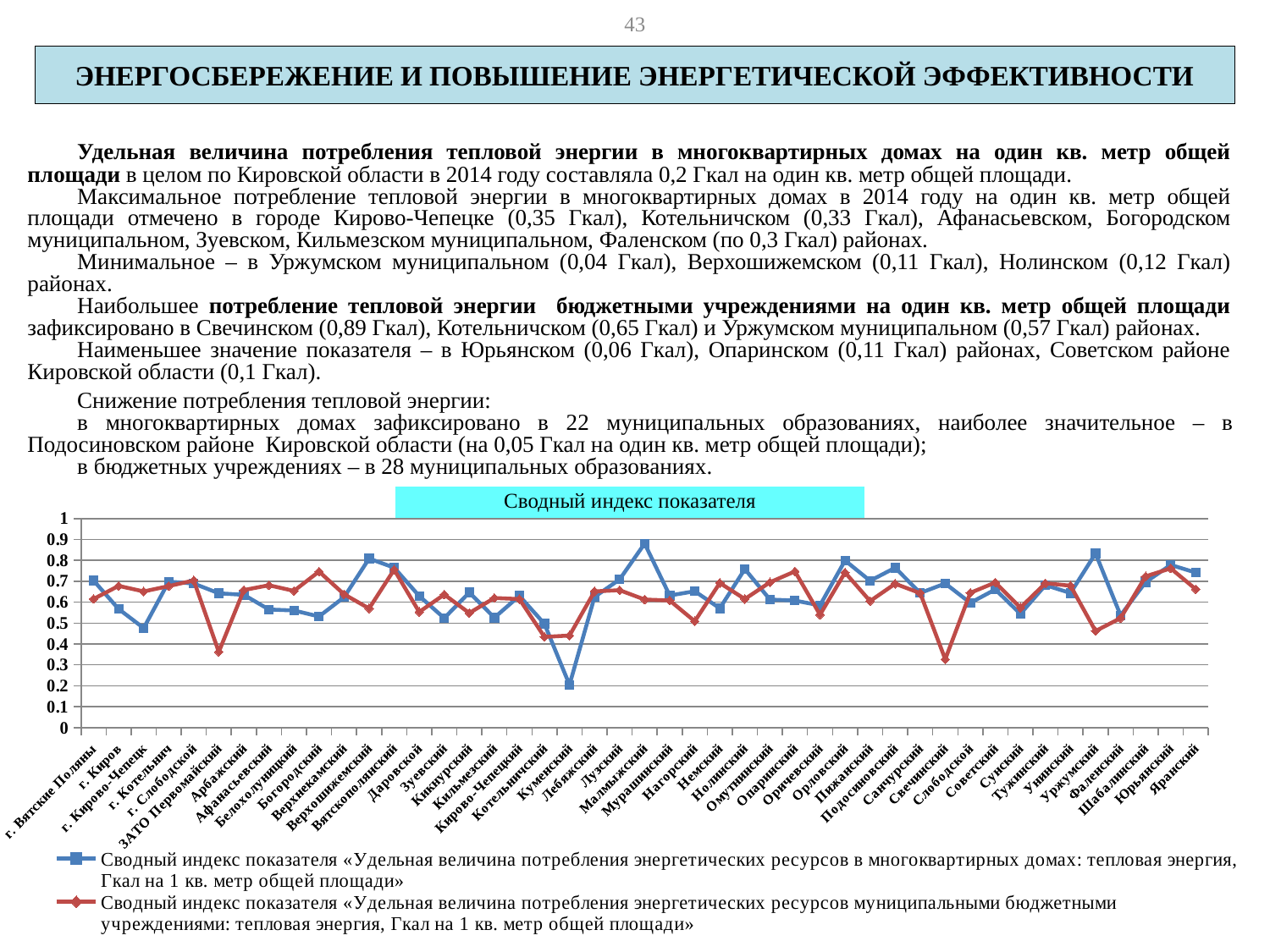
What kind of chart is shown on the slide? Line chart How many municipalities are shown along the x axis of the chart? 45 Is the blue series value for Куменский greater or less than 0.4? less How many series does the chart legend list? 2 For which municipality is the blue series (многоквартирные дома) highest? Малмыжский What is the title of the chart? Сводный индекс показателя Is the red series (бюджетные учреждения) value for Свечинский greater or less than 0.5? less Is the red series (бюджетные учреждения) value for ЗАТО Первомайский greater or less than 0.5? less Which marker colour is used for the series about multi-apartment buildings (многоквартирных домах)? Blue For which municipality is the blue series (многоквартирные дома) lowest? Куменский At Куменский, which series has the higher value: the blue (многоквартирные дома) or the red (бюджетные учреждения)? Red (бюджетные учреждения)